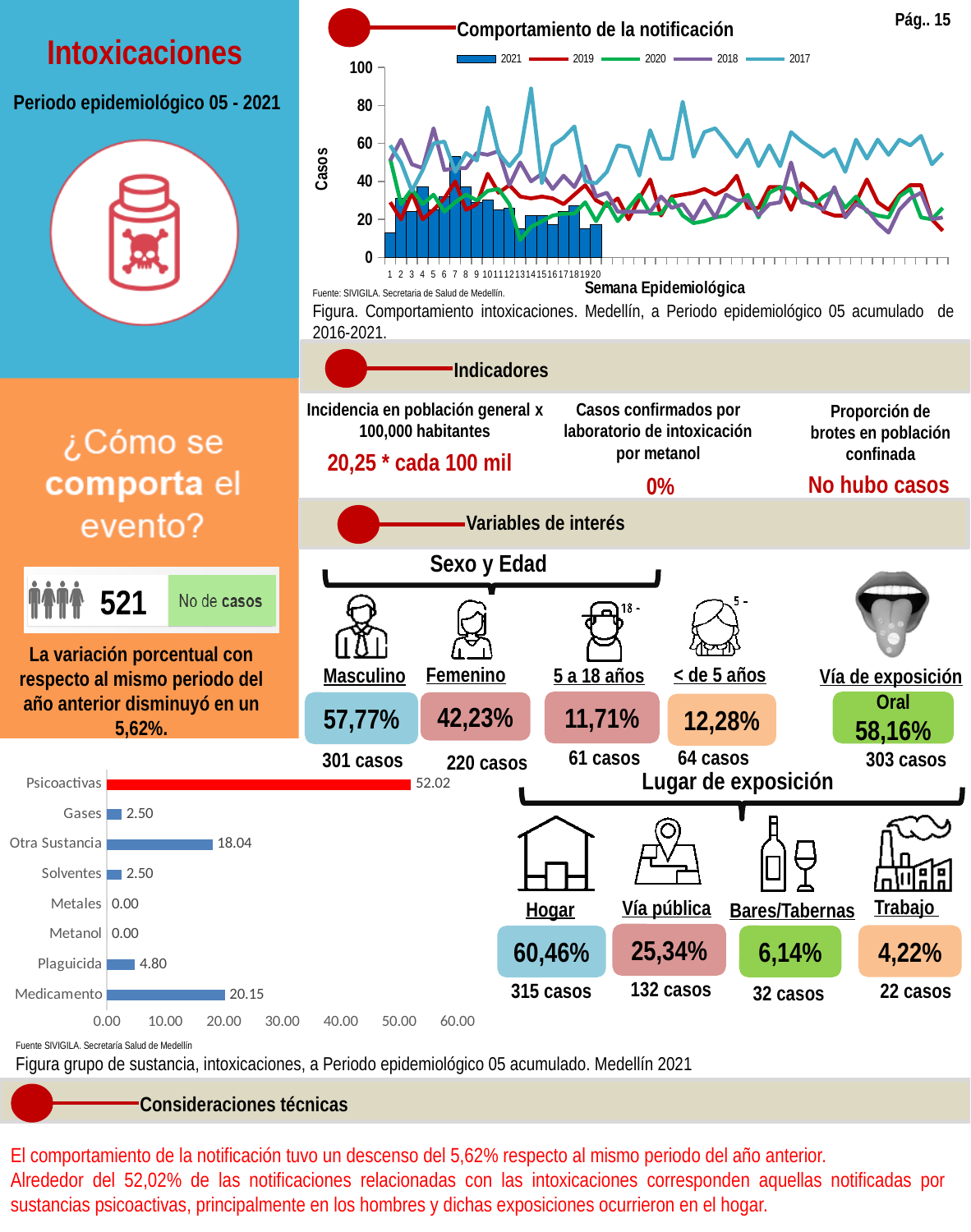
In the bottom-left bar chart of substance groups, how many categories are shown? 8 What kind of chart is the bottom-left chart of substance groups? Bar chart In the bottom-left bar chart of substance groups, which is larger, Otra Sustancia or Medicamento? Medicamento In the bottom-left bar chart of substance groups, what is the value for Psicoactivas? 52.02 In the 'Comportamiento de la notificación' chart, what is the label of the y axis? Casos In the bottom-left bar chart of substance groups, what is the difference between the values for Psicoactivas and Medicamento? 31.87 In the 'Comportamiento de la notificación' chart, how many series does the legend list? 5 In the bottom-left bar chart of substance groups, what is the value for Plaguicida? 4.80 In the bottom-left bar chart of substance groups, what is the value for Metanol? 0.00 In the 'Comportamiento de la notificación' chart, is the 2017 value at week 14 greater or less than 80? greater In the bottom-left bar chart of substance groups, what is the value for Medicamento? 20.15 In the bottom-left bar chart of substance groups, which category has the highest value? Psicoactivas